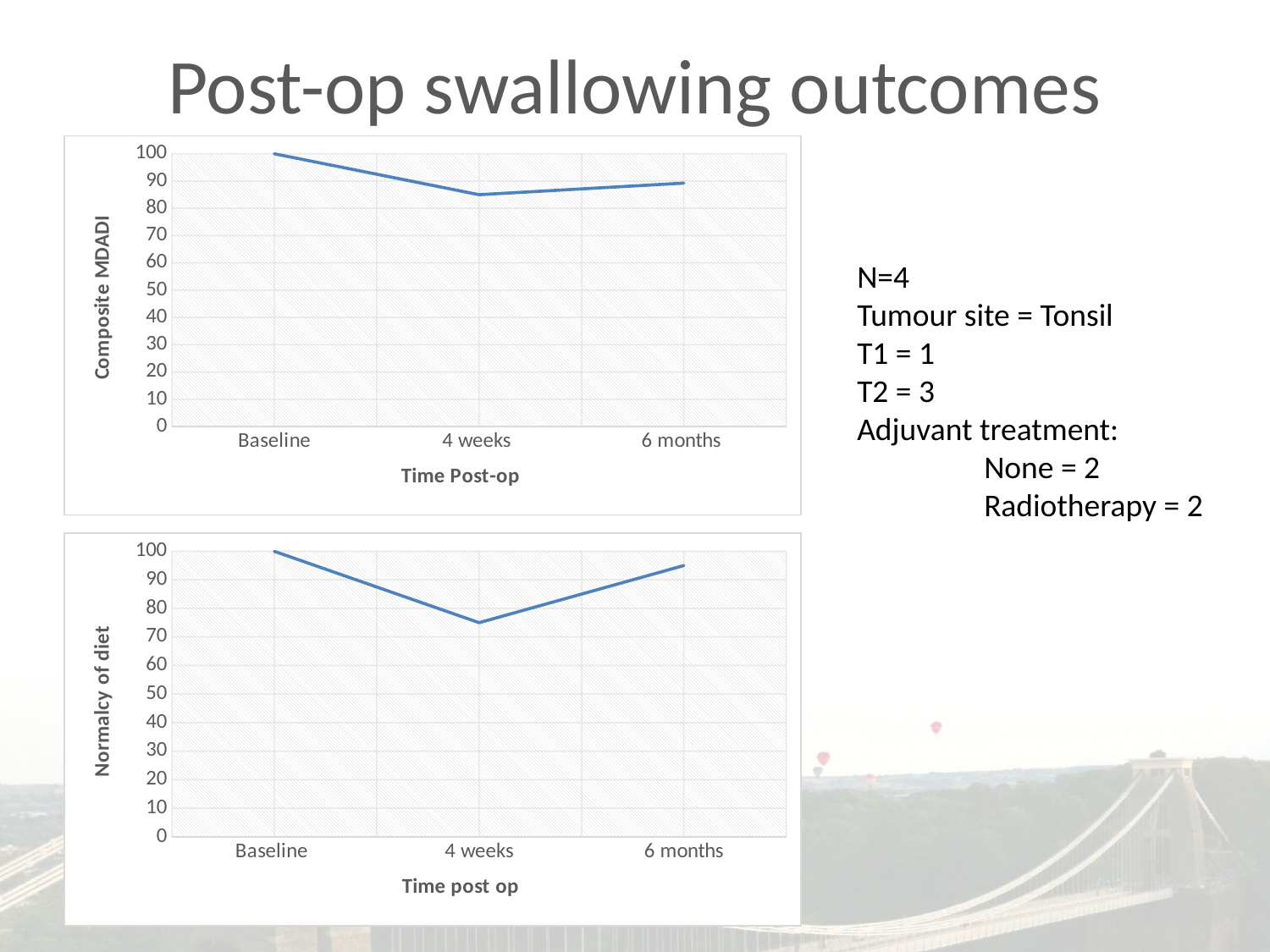
What kind of chart is the top chart (Composite MDADI)? line chart In the top chart (Composite MDADI), is the value at 6 months greater or less than 80? greater In the top chart (Composite MDADI), what is the value at Baseline? 100 In the bottom chart (Normalcy of diet), is the value at 6 months greater or less than 90? greater In the top chart (Composite MDADI), which time point has the lowest value? 4 weeks In the top chart (Composite MDADI), which time point has the highest value? Baseline In the bottom chart (Normalcy of diet), which time point has the lowest value? 4 weeks In the bottom chart (Normalcy of diet), what is the value at Baseline? 100 In the bottom chart (Normalcy of diet), is the value at 4 weeks greater or less than 80? less What is the y-axis title of the top chart? Composite MDADI How many time points are plotted in the top chart (Composite MDADI)? 3